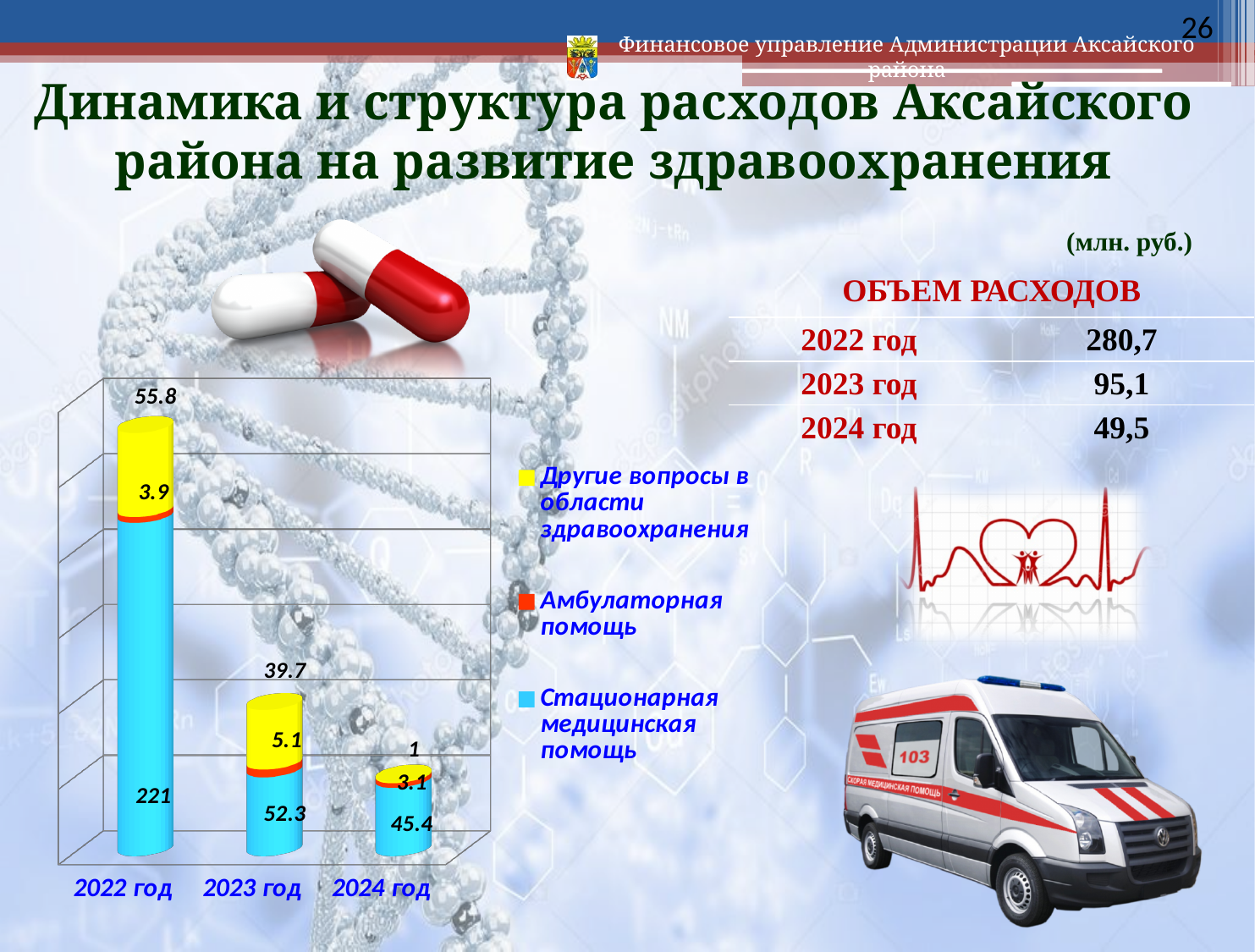
What is the value for Другие вопросы в области здравоохранения in 2023 год? 39.7 What type of chart is shown on the slide? bar chart What is the total of the stacked bar for 2024 год? 49.5 In which year is the value for Амбулаторная помощь the lowest? 2024 год In which year is the value for Стационарная медицинская помощь the highest? 2022 год What is the value for Другие вопросы в области здравоохранения in 2024 год? 1 How many series does the chart legend list? 3 Which is larger: Другие вопросы в области здравоохранения in 2022 год or in 2023 год? 2022 год What is the value for Амбулаторная помощь in 2024 год? 3.1 What is the difference between the Стационарная медицинская помощь values for 2022 год and 2023 год? 168.7 How many year categories are plotted in the chart? 3 What is the value for Стационарная медицинская помощь in 2022 год? 221